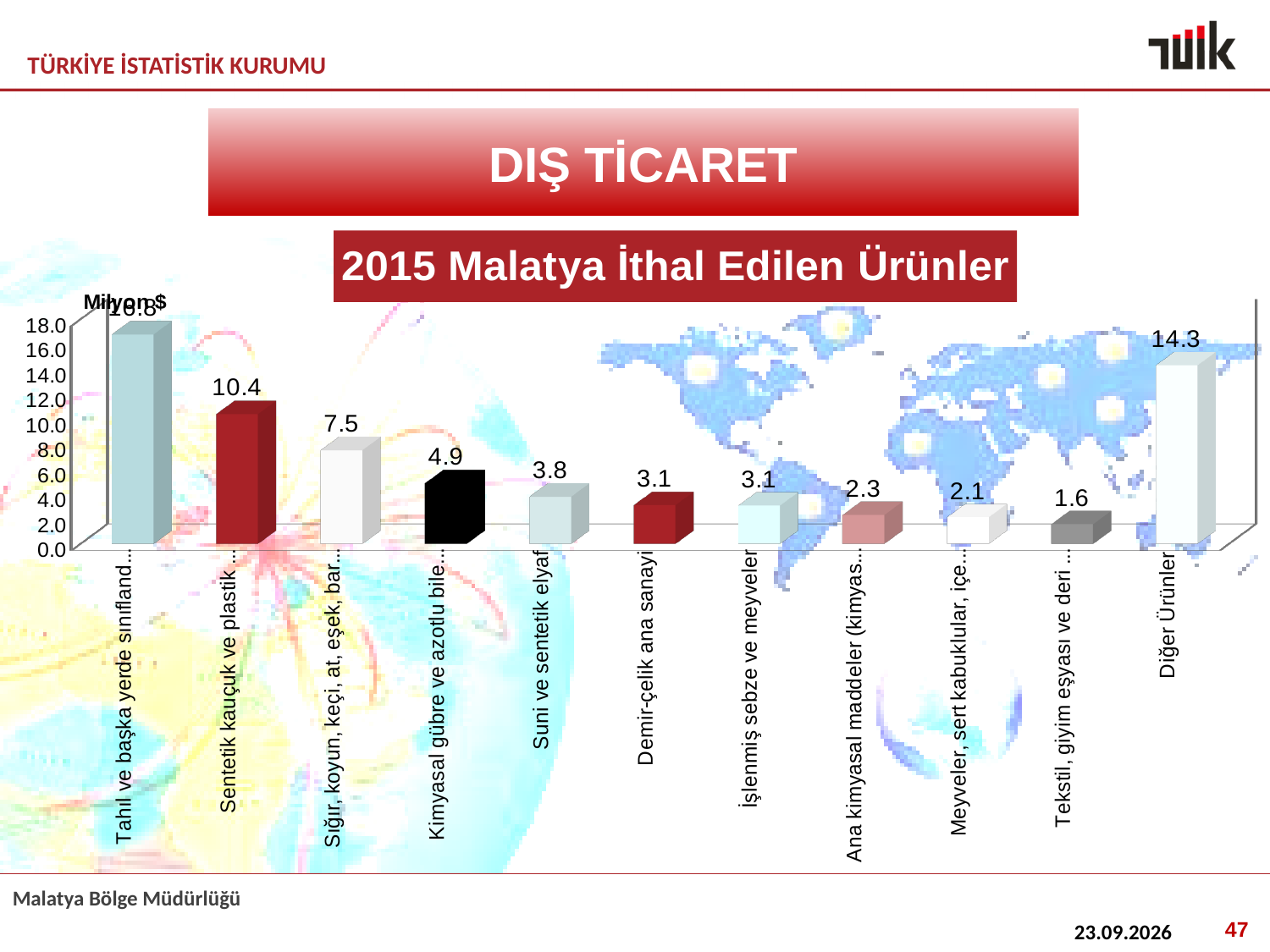
What is the difference between the values for Suni ve sentetik elyaf and Demir-çelik ana sanayi? 0.7 What is the value for Demir-çelik ana sanayi? 3.1 What is the value for Diğer Ürünler? 14.3 What is the value for İşlenmiş sebze ve meyveler? 3.1 What is the title of the chart? 2015 Malatya İthal Edilen Ürünler Which is larger, the value for Diğer Ürünler or the value for Demir-çelik ana sanayi? Diğer Ürünler What kind of chart is shown on the slide? bar chart How many categories (bars) are shown in the chart? 11 What unit is shown at the top of the vertical axis? Milyon $ What is the difference between the values for Diğer Ürünler and Suni ve sentetik elyaf? 10.5 What is the value for Suni ve sentetik elyaf? 3.8 Is the value for the leftmost bar (Tahıl ve başka yerde sınıfland...) greater or less than 14.0? greater